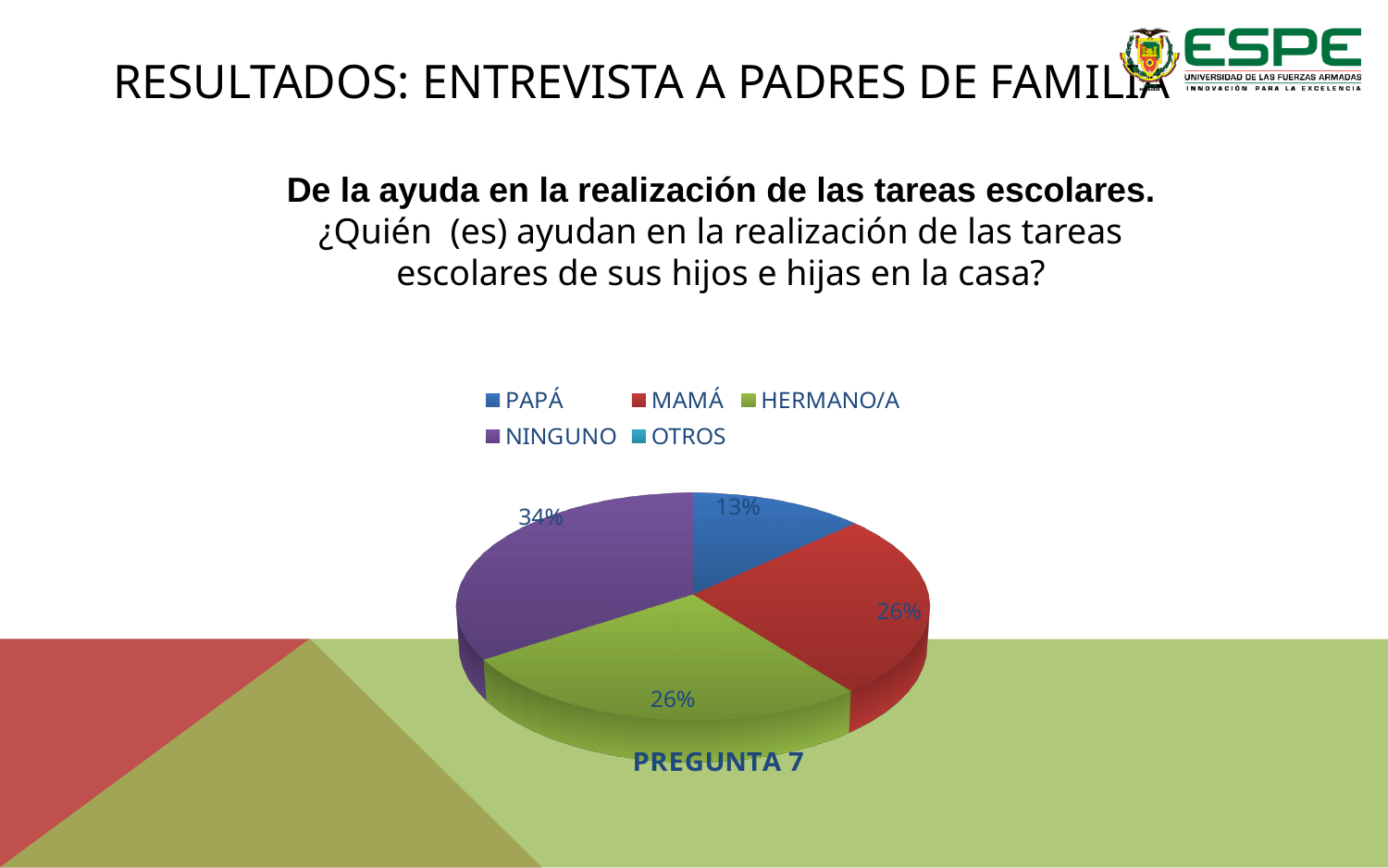
Of the slices visible in the pie, which is the smallest? PAPÁ By how many percentage points does the NINGUNO slice exceed the PAPÁ slice? 21 percentage points What percentage of the pie corresponds to MAMÁ? 26% How many entries does the legend of the pie chart list? 5 What percentage of the pie corresponds to NINGUNO? 34% Which category has the largest slice of the pie? NINGUNO What percentage of the pie corresponds to PAPÁ? 13% What colour represents NINGUNO in the pie chart? Purple What kind of chart is shown on the slide? Pie chart Which slice is larger, NINGUNO or MAMÁ? NINGUNO What is the title shown below the pie chart? PREGUNTA 7 What percentage of the pie corresponds to HERMANO/A? 26%